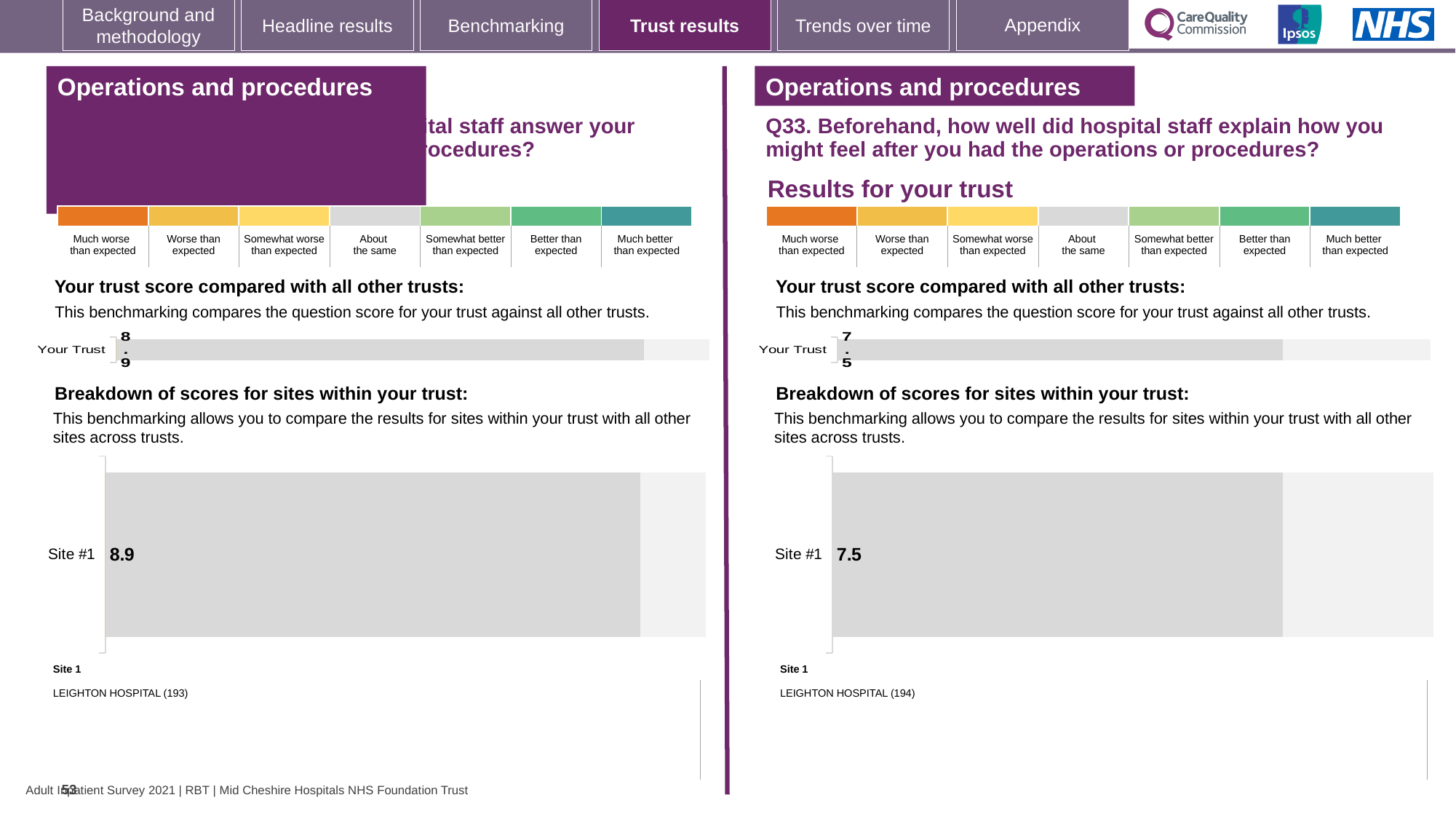
What kind of chart is used to show the Your Trust score on each panel? bar chart On the right-hand panel (Q33), what is the score shown for Your Trust? 7.5 On the left-hand panel, is the Site #1 score greater or less than the Your Trust score, or are they equal? equal On the left-hand panel, what is the score shown for Site #1 in the breakdown of scores for sites within your trust? 8.9 On the right-hand panel (Q33), what is the score shown for Site #1 in the breakdown of scores for sites within your trust? 7.5 What is the difference between the Your Trust score on the left-hand panel and the Your Trust score on the right-hand panel (Q33)? 1.4 Which panel shows the higher Your Trust score, the left-hand panel or the right-hand panel (Q33)? the left-hand panel How many sites are listed in the breakdown of scores for sites within your trust on the right-hand panel (Q33)? 1 On the right-hand panel (Q33), which hospital is listed as Site 1? LEIGHTON HOSPITAL (194) On the left-hand panel, what is the score shown for Your Trust? 8.9 On the left-hand panel, which hospital is listed as Site 1? LEIGHTON HOSPITAL (193)